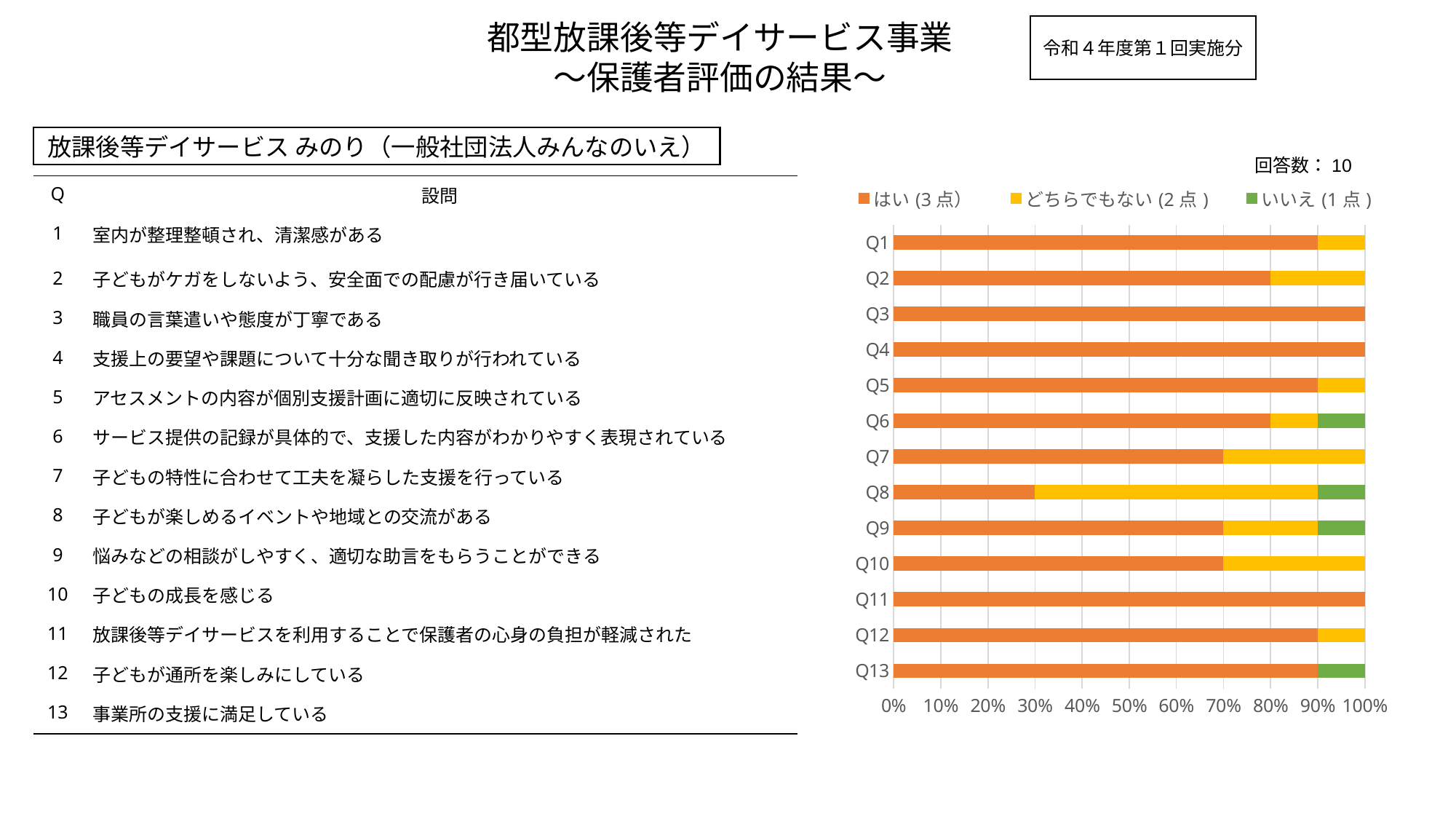
How many series does the chart legend list? 3 What share of responses for Q1 is はい (3 点)? 90% What share of responses for Q3 is はい (3 点)? 100% Is the どちらでもない (2 点) share for Q8 greater or less than 50%? greater What is the first entry in the chart legend? はい (3 点) What share of responses for Q8 is はい (3 点)? 30% How many questions (categories) are plotted on the chart? 13 Is the はい (3 点) share for Q7 greater or less than 80%? less How many questions have an いいえ (1 点) segment in the chart? 4 Which has a larger はい (3 点) share, Q2 or Q5? Q5 Which question has the lowest share of はい (3 点) responses? Q8 What kind of chart is shown on the slide? bar chart